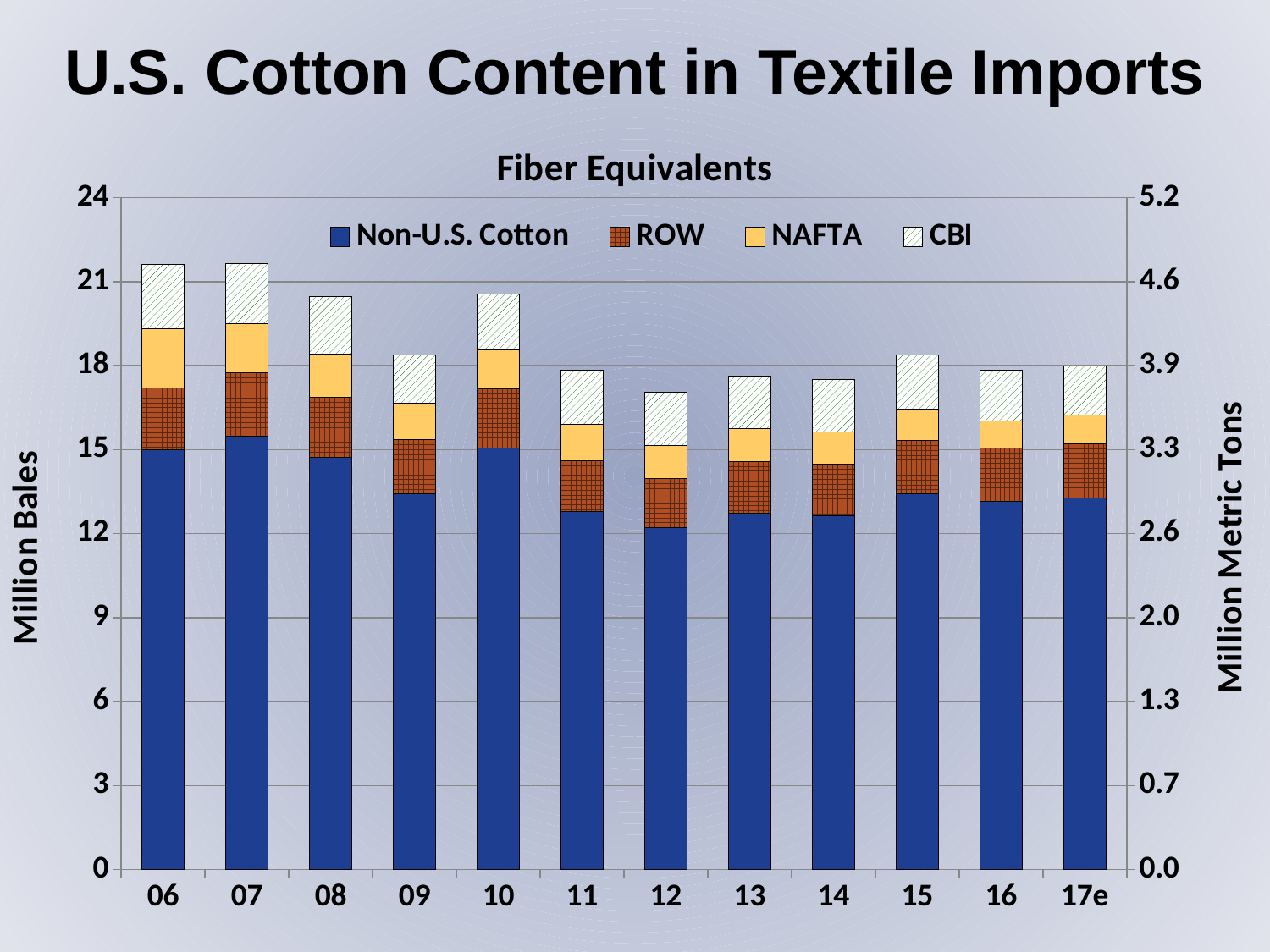
Which year has the larger total bar, 06 or 12? 06 How many series does the legend list? 4 Is the total bar height for 08 greater or less than 21 million bales? less Which year has the highest Non-U.S. Cotton segment? 07 Is the total bar height for 06 greater or less than 21 million bales? greater Which year has the lowest Non-U.S. Cotton segment? 12 Is the total bar height for 12 greater or less than 18 million bales? less What kind of chart is shown on the slide? Stacked bar chart How many years (categories) are shown along the x axis? 12 Which year has the lowest total bar height? 12 What is the label on the right-hand vertical axis? Million Metric Tons